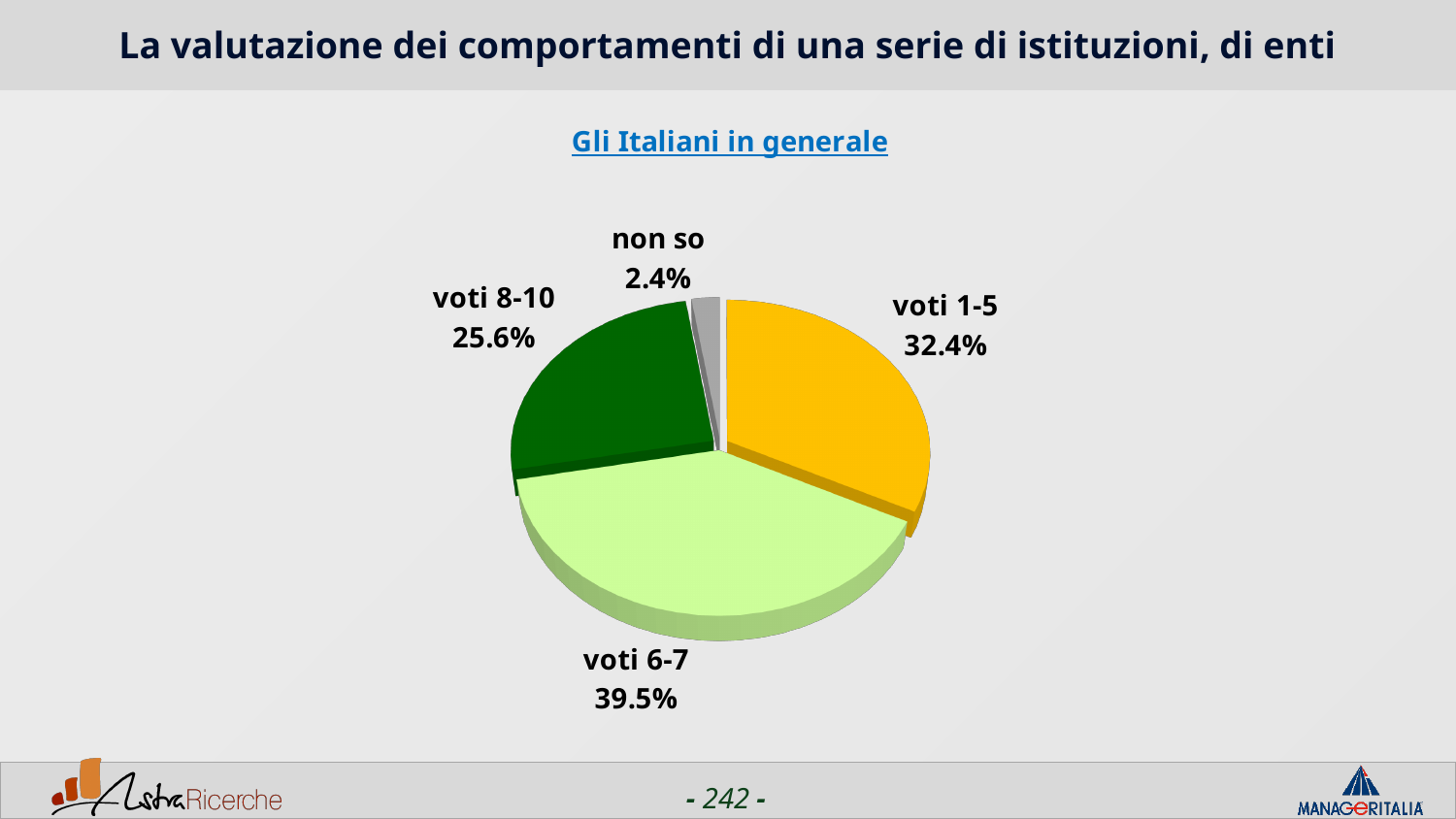
What colour is the 'voti 1-5' slice? yellow/orange What is the difference between the 'voti 6-7' and 'voti 1-5' slices? 7.1% What is the value of the 'non so' slice? 2.4% How many slices does the pie chart have? 4 What is the value shown for the 'voti 1-5' slice? 32.4% Which slice is the smallest in the pie chart? non so What kind of chart is shown on the slide? pie chart What is the subtitle shown above the pie chart? Gli Italiani in generale Which is larger, 'voti 1-5' or 'voti 8-10'? voti 1-5 Which slice is the largest in the pie chart? voti 6-7 What share does the 'voti 8-10' slice have? 25.6% What percentage of the pie is labelled 'voti 6-7'? 39.5%